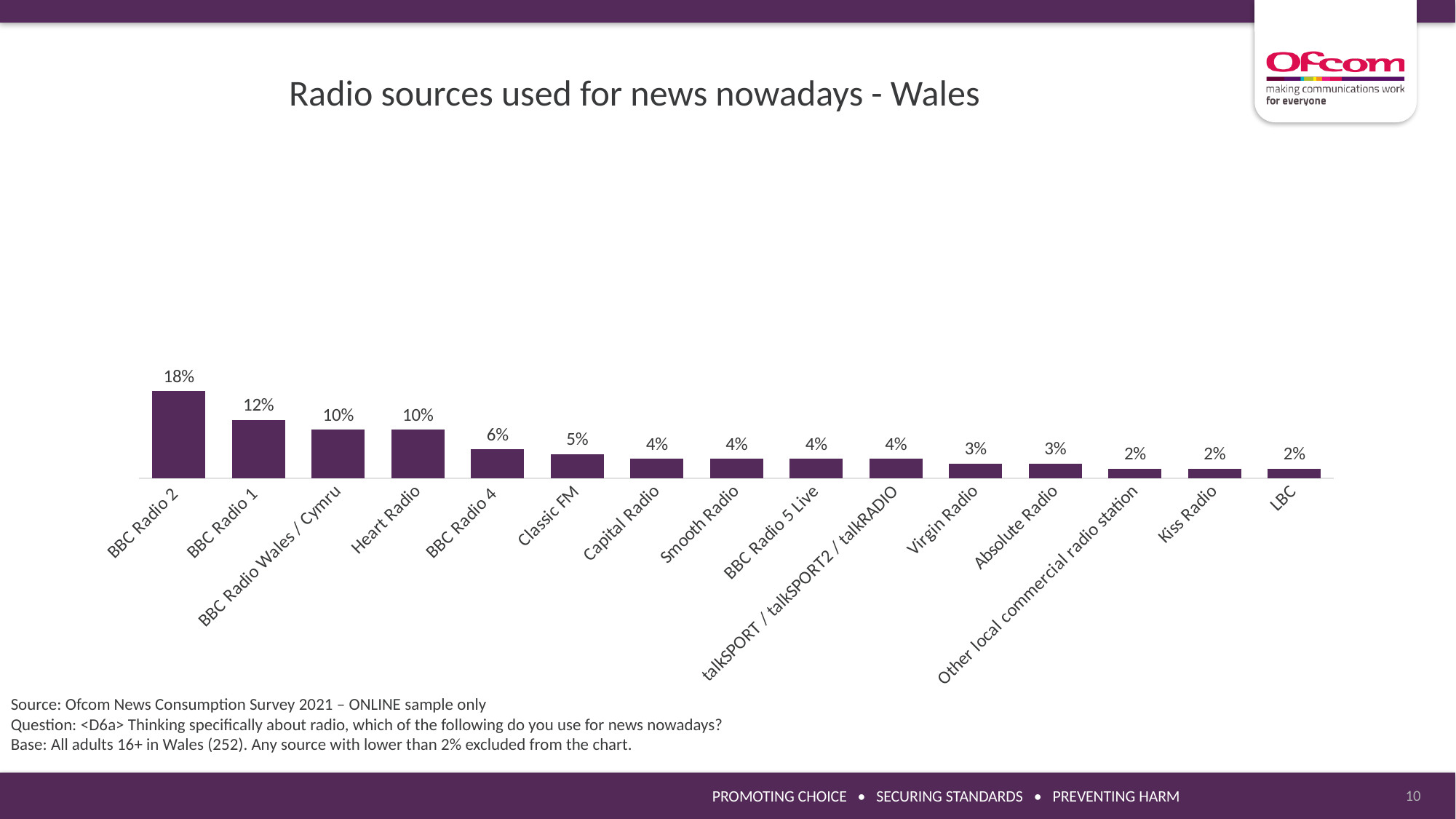
Which has a larger value, Capital Radio or Kiss Radio? Capital Radio Do the values rise or fall moving from left to right along the x axis? Fall What is the value shown for Classic FM? 5% What is the value shown for LBC? 2% What is the difference between the values for BBC Radio 2 and BBC Radio 1? 6% Which radio source has the highest value on the chart? BBC Radio 2 What is the difference between the values for BBC Radio 4 and Virgin Radio? 3% What percentage of adults in Wales use BBC Radio 2 for news nowadays? 18% What is the value shown for Heart Radio? 10% What kind of chart is shown on the slide? Bar chart Which has a larger value, BBC Radio Wales / Cymru or BBC Radio 4? BBC Radio Wales / Cymru How many radio sources are shown on the chart? 15